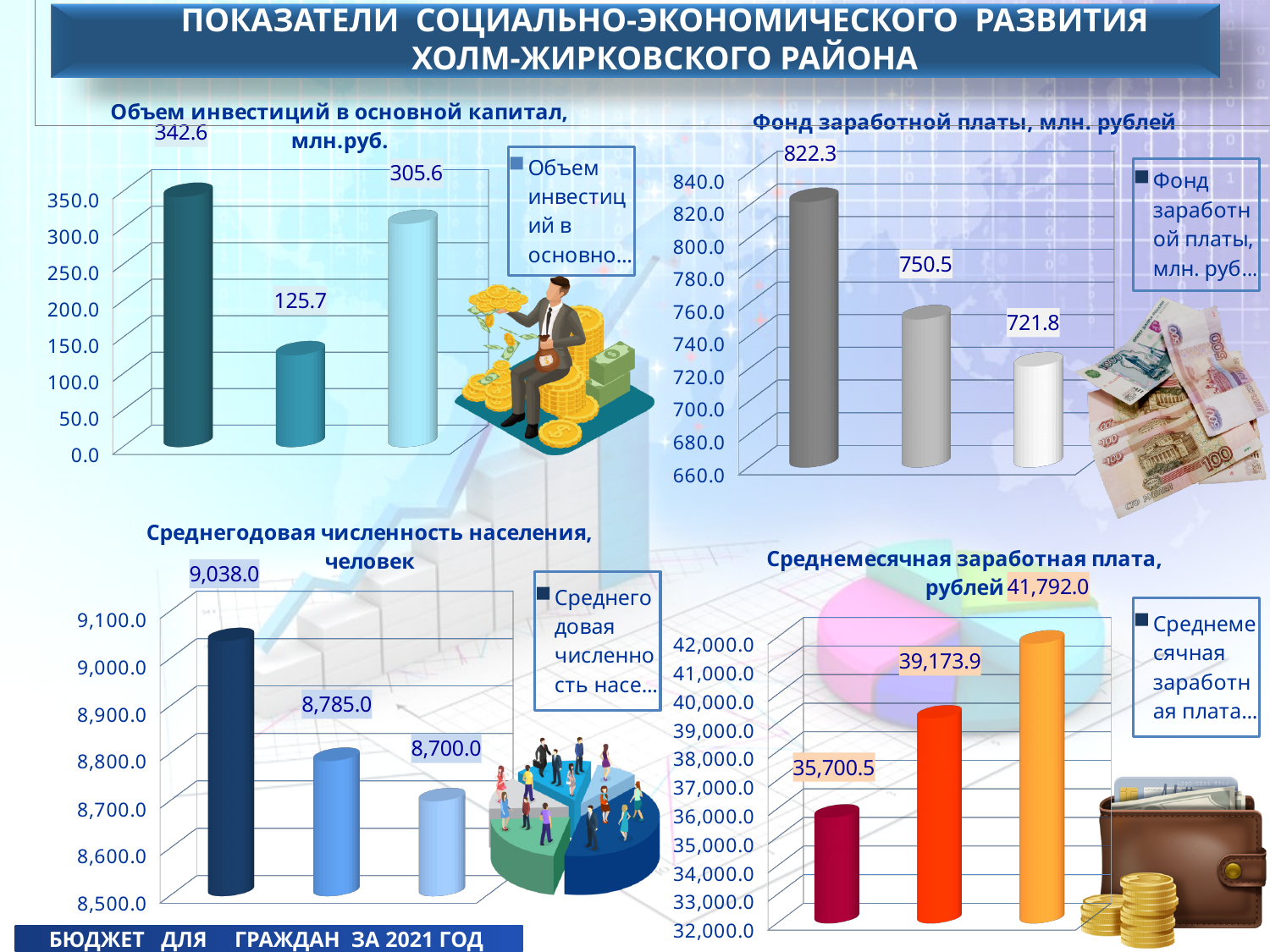
In the chart 'Среднемесячная заработная плата, рублей', what is the value of the first (leftmost) bar? 35,700.5 In the chart 'Среднегодовая численность населения, человек', what is the value of the second (middle) bar? 8,785.0 In the chart 'Среднемесячная заработная плата, рублей', which is larger: the second bar or the third bar? the third bar (41,792.0) In the chart 'Среднегодовая численность населения, человек', which bar has the highest value? the first (leftmost) bar, 9,038.0 What type of chart is 'Среднегодовая численность населения, человек'? bar chart In the chart 'Объем инвестиций в основной капитал, млн.руб.', what is the difference between the first bar and the third bar? 37.0 In the chart 'Фонд заработной платы, млн. рублей', what is the value of the third (rightmost) bar? 721.8 In the chart 'Объем инвестиций в основной капитал, млн.руб.', what is the value of the first (leftmost) bar? 342.6 How many bars are plotted in the chart 'Среднемесячная заработная плата, рублей'? 3 In the chart 'Фонд заработной платы, млн. рублей', what is the difference between the first bar and the second bar? 71.8 In the chart 'Фонд заработной платы, млн. рублей', do the values rise or fall from left to right? fall In the chart 'Объем инвестиций в основной капитал, млн.руб.', which bar has the lowest value? the second (middle) bar, 125.7